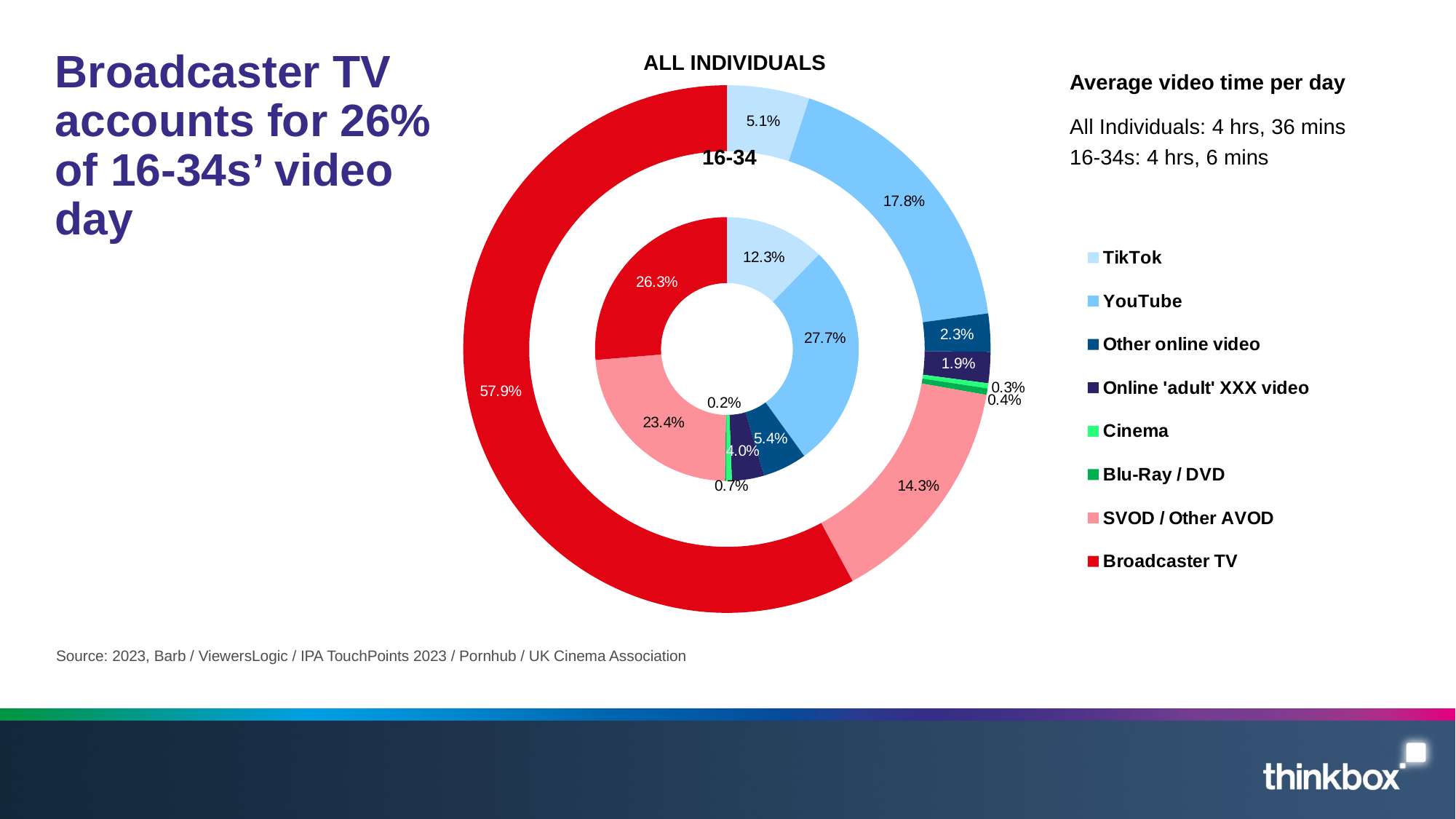
In the ALL INDIVIDUALS ring, what share does Broadcaster TV account for? 57.9% In the 16-34 ring, what share does YouTube account for? 27.7% In the 16-34 ring, which is larger: the share for SVOD / Other AVOD or the share for TikTok? SVOD / Other AVOD What kind of chart is shown on the slide? Doughnut chart How many categories does the legend list? 8 Which category has the largest share in the ALL INDIVIDUALS ring? Broadcaster TV In the 16-34 ring, what share does Broadcaster TV account for? 26.3% What is the difference between the Broadcaster TV share for ALL INDIVIDUALS and for 16-34? 31.6% In the ALL INDIVIDUALS ring, what share does SVOD / Other AVOD account for? 14.3% According to the text on the slide, what is the average video time per day for 16-34s? 4 hrs, 6 mins Which category has the largest share in the 16-34 ring? YouTube In the 16-34 ring, what share does TikTok account for? 12.3%